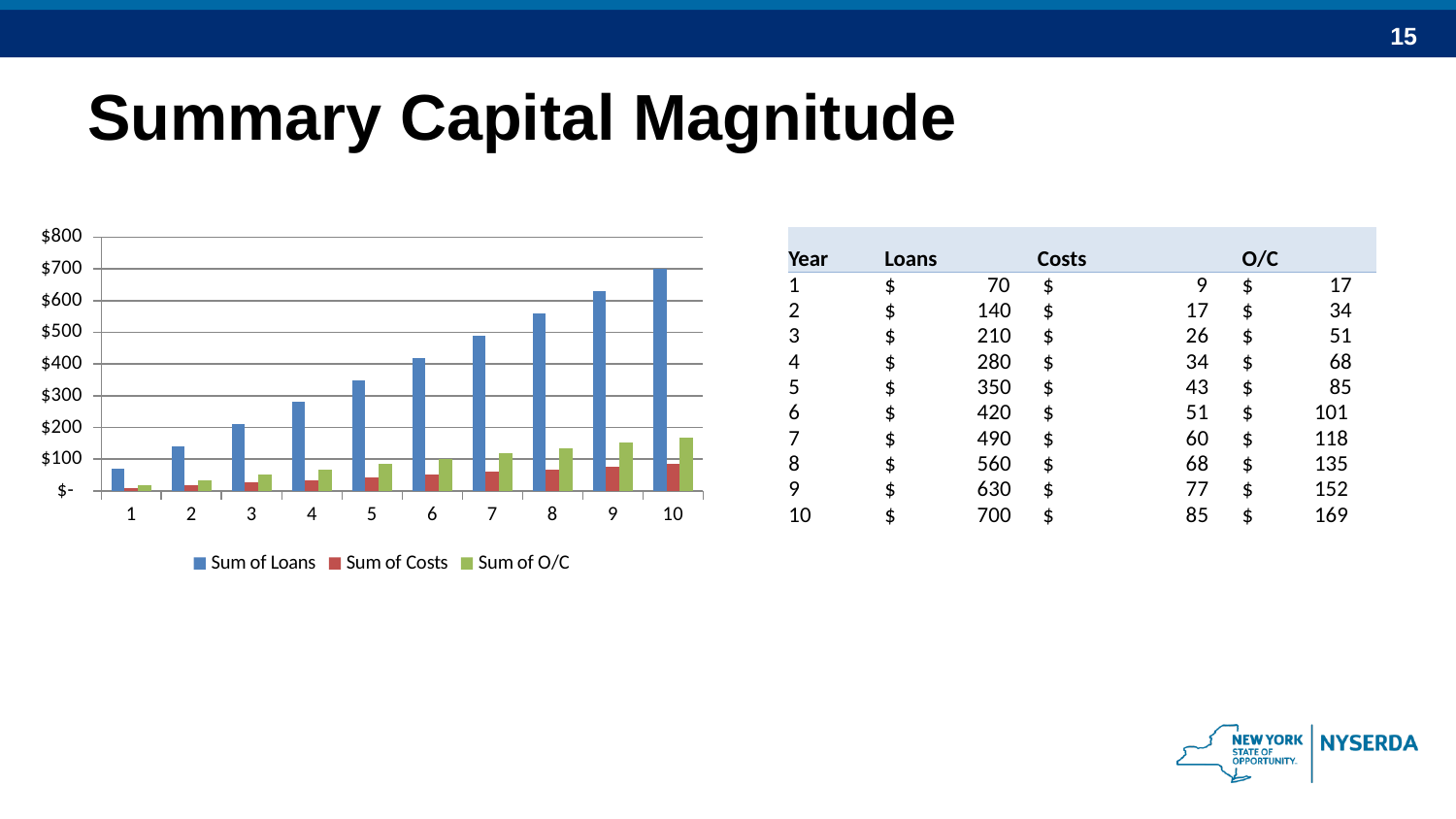
Which year has the lowest Sum of Loans in the chart? 1 What is the Sum of O/C value for year 6? $101 How many years (categories) are plotted along the x axis of the chart? 10 How many series does the chart's legend list? 3 What is the Sum of Loans value for year 10? $700 Which year has the highest Sum of Loans in the chart? 10 In year 5, which is larger: Sum of Costs or Sum of O/C? Sum of O/C Is the Sum of Loans value for year 7 greater or less than $400? greater Do the Sum of Loans values rise or fall from year 1 to year 10? rise What kind of chart is shown on the slide? bar chart What are the three series names listed in the chart's legend? Sum of Loans, Sum of Costs, Sum of O/C What is the difference between the Sum of Loans for year 10 and for year 1? $630